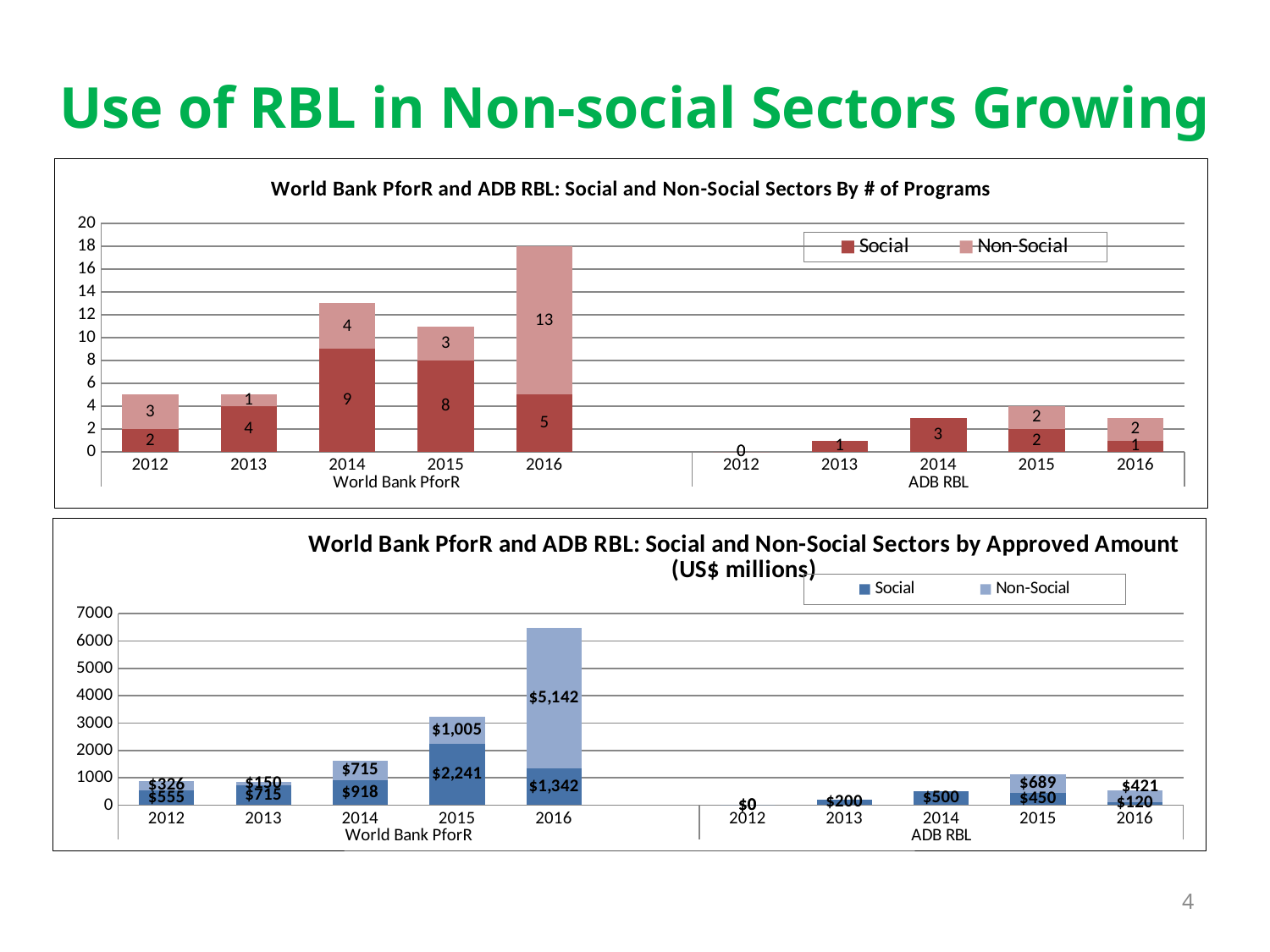
In the bottom chart (by Approved Amount), is the total stacked bar for World Bank PforR in 2016 greater or less than 6000? greater In the top chart (By # of Programs), what is the difference between Social and Non-Social programs for World Bank PforR in 2015? 5 In the top chart (By # of Programs), which year has the tallest stacked bar for World Bank PforR? 2016 What type of chart is the bottom chart (by Approved Amount)? Stacked bar chart In the bottom chart (by Approved Amount), what is the Non-Social approved amount for World Bank PforR in 2016? $5,142 In the top chart (By # of Programs), what is the total number of programs for World Bank PforR in 2016? 18 In the bottom chart (by Approved Amount), which is larger for World Bank PforR in 2014: the Social amount or the Non-Social amount? Social In the bottom chart (by Approved Amount), what is the Social approved amount for World Bank PforR in 2015? $2,241 In the bottom chart (by Approved Amount), what is the Non-Social approved amount for ADB RBL in 2015? $689 In the top chart (By # of Programs), how many Social programs did World Bank PforR have in 2014? 9 In the top chart (By # of Programs), how many series does the legend list? 2 In the top chart (By # of Programs), how many Non-Social programs did World Bank PforR have in 2016? 13